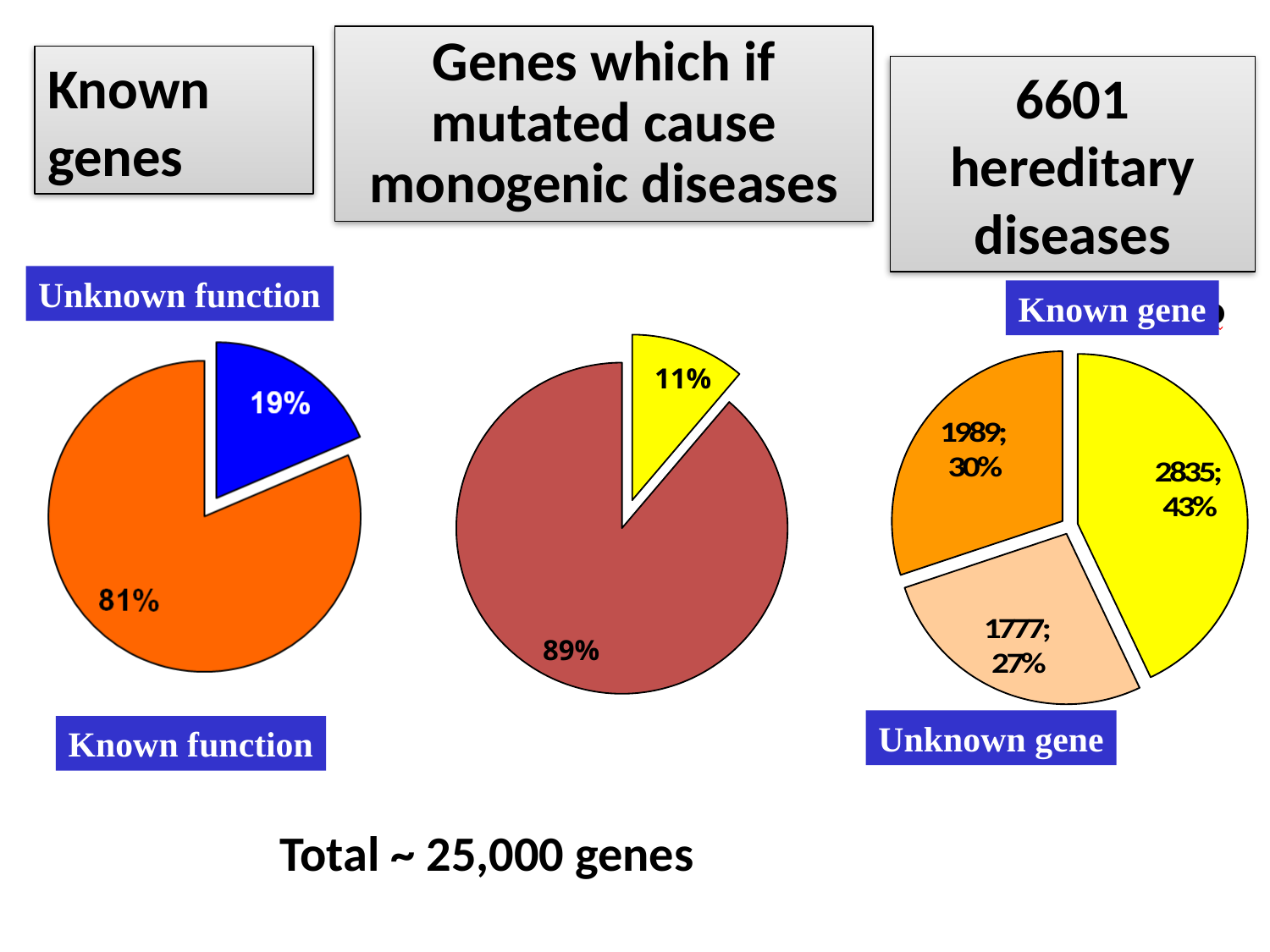
In the '6601 hereditary diseases' pie chart on the right, what is the difference between the slice of 1989 and the slice of 1777? 212 In the '6601 hereditary diseases' pie chart on the right, what share does the 'Known gene' slice represent? 43% How many slices does the middle pie chart ('Genes which if mutated cause monogenic diseases') have? 2 How many slices does the 'Known genes' pie chart on the left have? 2 How many slices does the '6601 hereditary diseases' pie chart on the right have? 3 In the 'Known genes' pie chart on the left, which slice is larger, Known function or Unknown function? Known function In the middle pie chart ('Genes which if mutated cause monogenic diseases'), what is the share of the smallest slice? 11% In the 'Known genes' pie chart on the left, what share of genes has known function? 81% What kind of chart is the 'Known genes' chart on the left? Pie chart In the middle pie chart ('Genes which if mutated cause monogenic diseases'), what is the share of the largest slice? 89% In the '6601 hereditary diseases' pie chart on the right, how many diseases are in the 'Known gene' slice? 2835 In the 'Known genes' pie chart on the left, what share of genes has unknown function? 19%